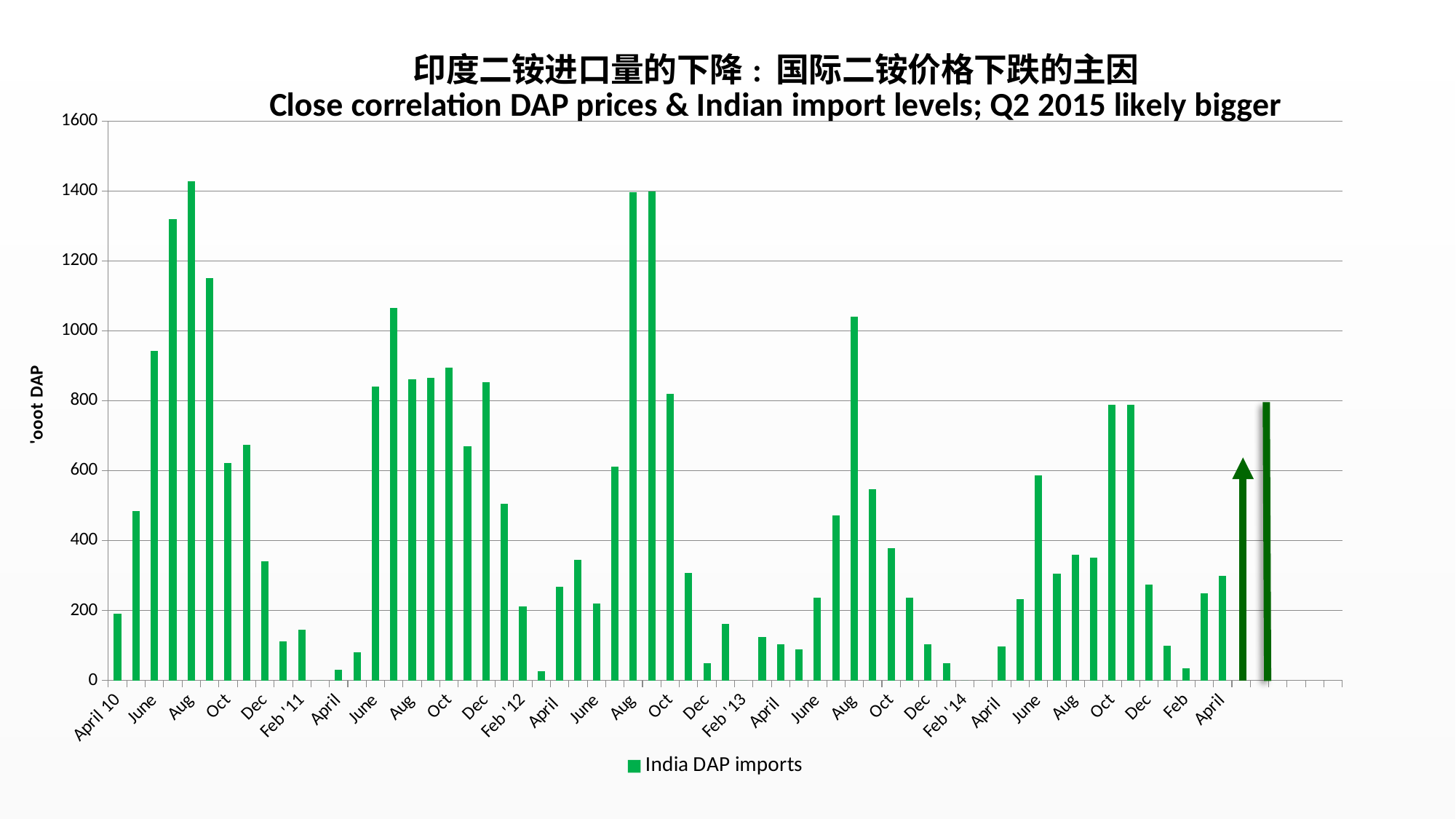
What is the legend entry for the series shown? India DAP imports Is the value for Feb '14 greater or less than 200? less Which is larger, the value for Aug 2010 or the value for Aug 2011? Aug 2010 What kind of chart is shown on the slide? bar chart Do the values rise or fall from April 10 to Aug 2010? rise What is the label on the vertical axis? 'ooot DAP How many series does the legend list? 1 Is the value for June (2011) greater or less than 800? greater Is the value for Feb '11 greater or less than 200? less